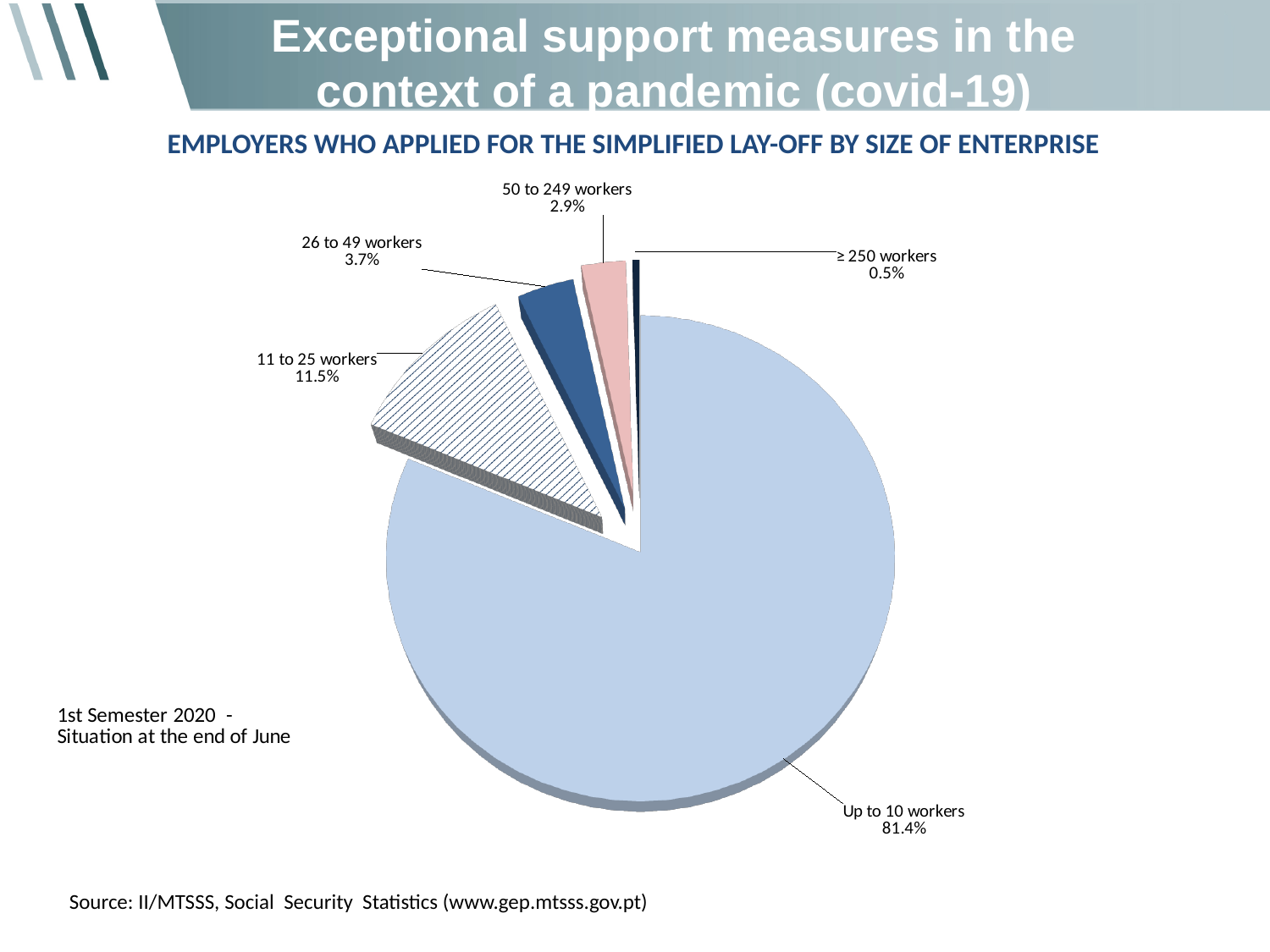
What percentage is shown for enterprises with 11 to 25 workers? 11.5% How many enterprise size categories are shown in the pie chart? 5 What kind of chart is shown on the slide? Pie chart What percentage is shown for enterprises with 50 to 249 workers? 2.9% What is the difference in percentage points between the 'Up to 10 workers' slice and the '11 to 25 workers' slice? 69.9 Which enterprise size category has the smallest share of the pie? ≥ 250 workers Which is larger: the share for 26 to 49 workers or the share for 50 to 249 workers? 26 to 49 workers Which enterprise size category has the largest share of the pie? Up to 10 workers What is the title of the chart? EMPLOYERS WHO APPLIED FOR THE SIMPLIFIED LAY-OFF BY SIZE OF ENTERPRISE What percentage is shown for enterprises with 26 to 49 workers? 3.7% What share of employers who applied for the simplified lay-off had up to 10 workers? 81.4% What percentage is shown for enterprises with 250 or more workers? 0.5%